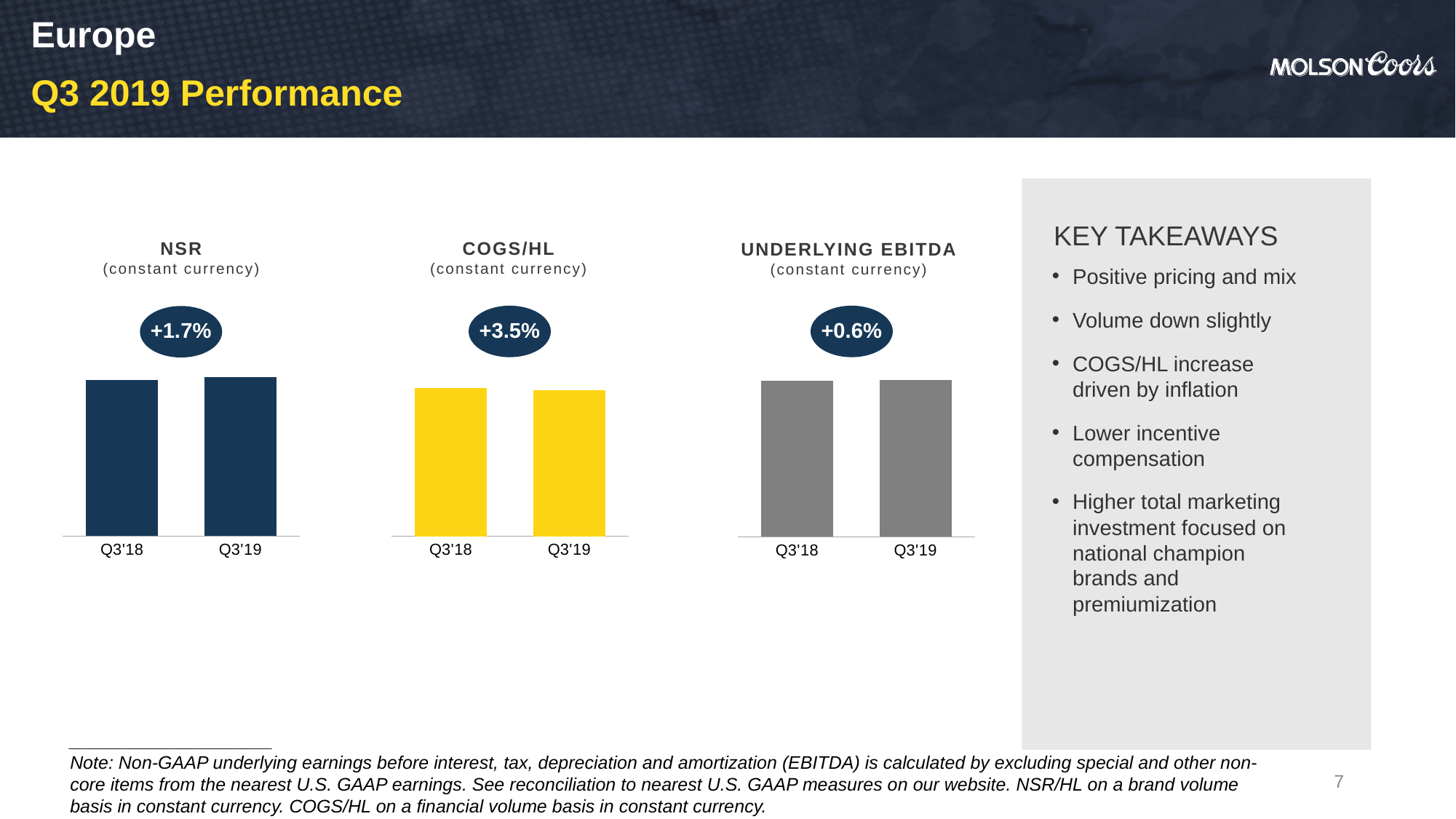
On the UNDERLYING EBITDA (constant currency) chart, what percentage change is shown between Q3'18 and Q3'19? +0.6% What colour are the bars on the COGS/HL (constant currency) chart? yellow On the NSR (constant currency) chart, which quarter has the taller bar? Q3'19 Which of the three charts shows the largest percentage increase from Q3'18 to Q3'19? COGS/HL How many bars are plotted on the COGS/HL (constant currency) chart? 2 On the NSR (constant currency) chart, what percentage change is shown between Q3'18 and Q3'19? +1.7% On the COGS/HL (constant currency) chart, which quarter has the taller bar? Q3'18 On the COGS/HL (constant currency) chart, what percentage change is shown between Q3'18 and Q3'19? +3.5% How many bar charts are shown on the slide? 3 Which of the three charts shows the smallest percentage increase from Q3'18 to Q3'19? UNDERLYING EBITDA What kind of chart is the NSR (constant currency) chart? bar chart